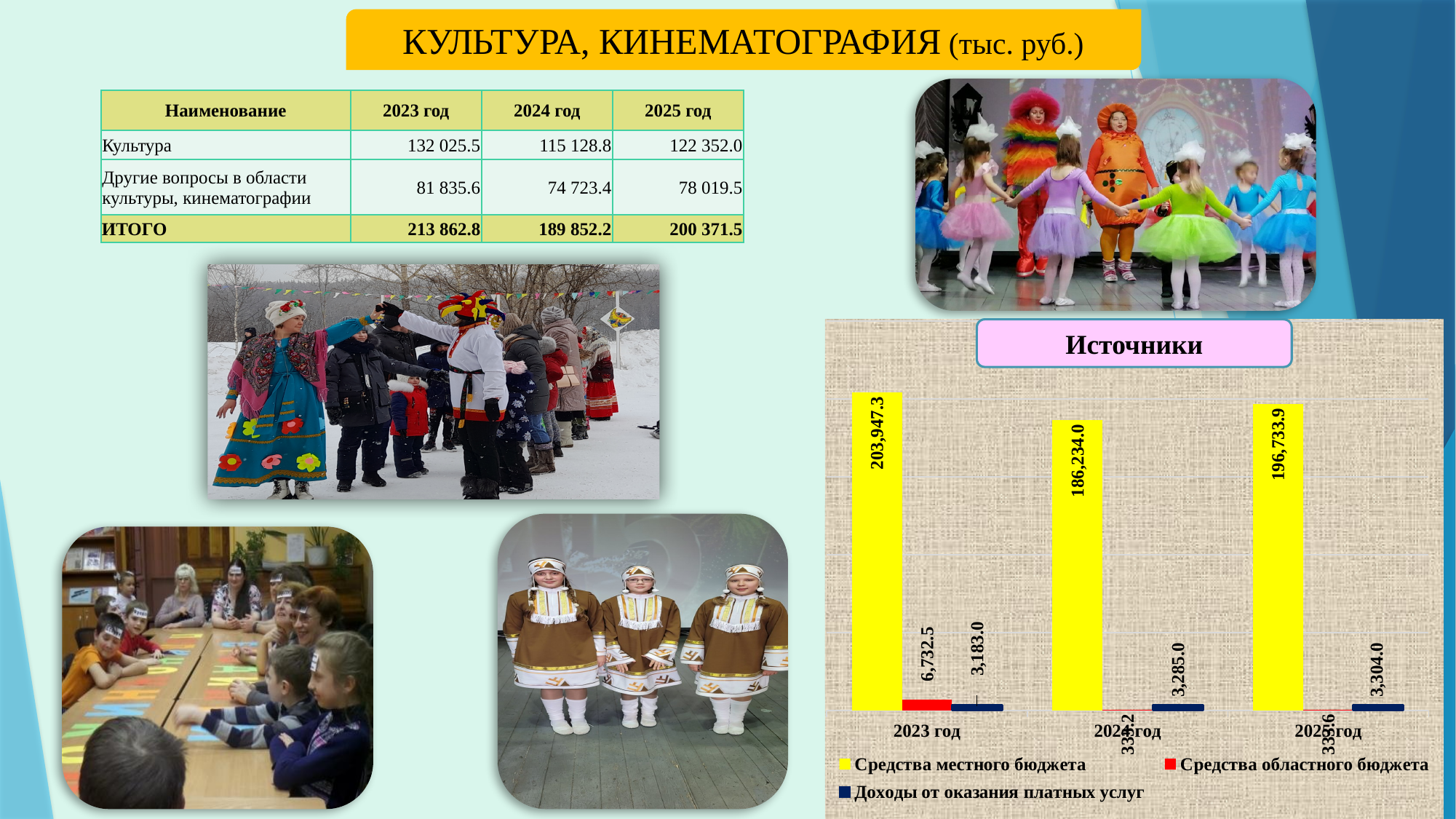
In the 'Источники' chart, which is larger: Доходы от оказания платных услуг in 2023 год or in 2024 год? 2024 год In the 'Источники' chart, which year has the highest value for Средства местного бюджета? 2023 год In the 'Источники' chart, what is the value of Средства местного бюджета for 2023 год? 203,947.3 In the 'Источники' chart, what is the value of Доходы от оказания платных услуг for 2025 год? 3,304.0 In the 'Источники' chart, what is the value of Средства местного бюджета for 2025 год? 196,733.9 What type of chart is the 'Источники' chart? Bar chart In the 'Источники' chart, what is the difference between Средства местного бюджета in 2023 год and 2024 год? 17,713.3 How many series does the legend of the 'Источники' chart list? 3 In the 'Источники' chart, what is the value of Средства областного бюджета for 2023 год? 6,732.5 How many year categories are shown on the x axis of the 'Источники' chart? 3 In the 'Источники' chart, what is the value of Средства местного бюджета for 2024 год? 186,234.0 In the 'Источники' chart, which year has the lowest value for Средства местного бюджета? 2024 год